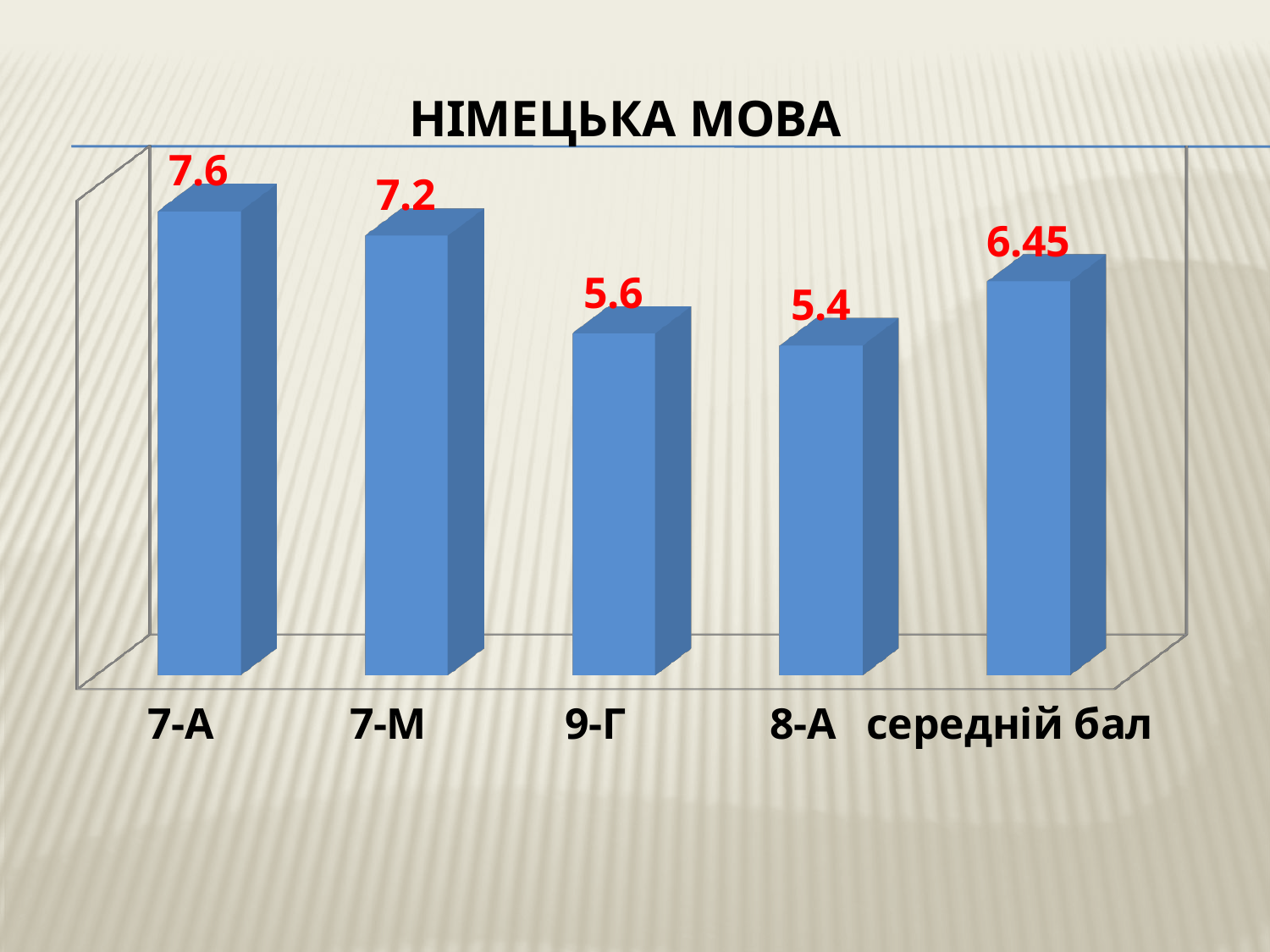
What is the value for 7-А? 7.6 What is the title of the chart? НІМЕЦЬКА МОВА Which category has the lowest value? 8-А Which is larger, the value for 7-М or the value for 9-Г? 7-М What is the value for 8-А? 5.4 What is the value for середній бал? 6.45 What kind of chart is shown on the slide? bar chart How many categories are shown on the chart? 5 What is the value for 7-М? 7.2 Which category has the highest value? 7-А What is the value for 9-Г? 5.6 What is the difference between the values for 7-А and 8-А? 2.2